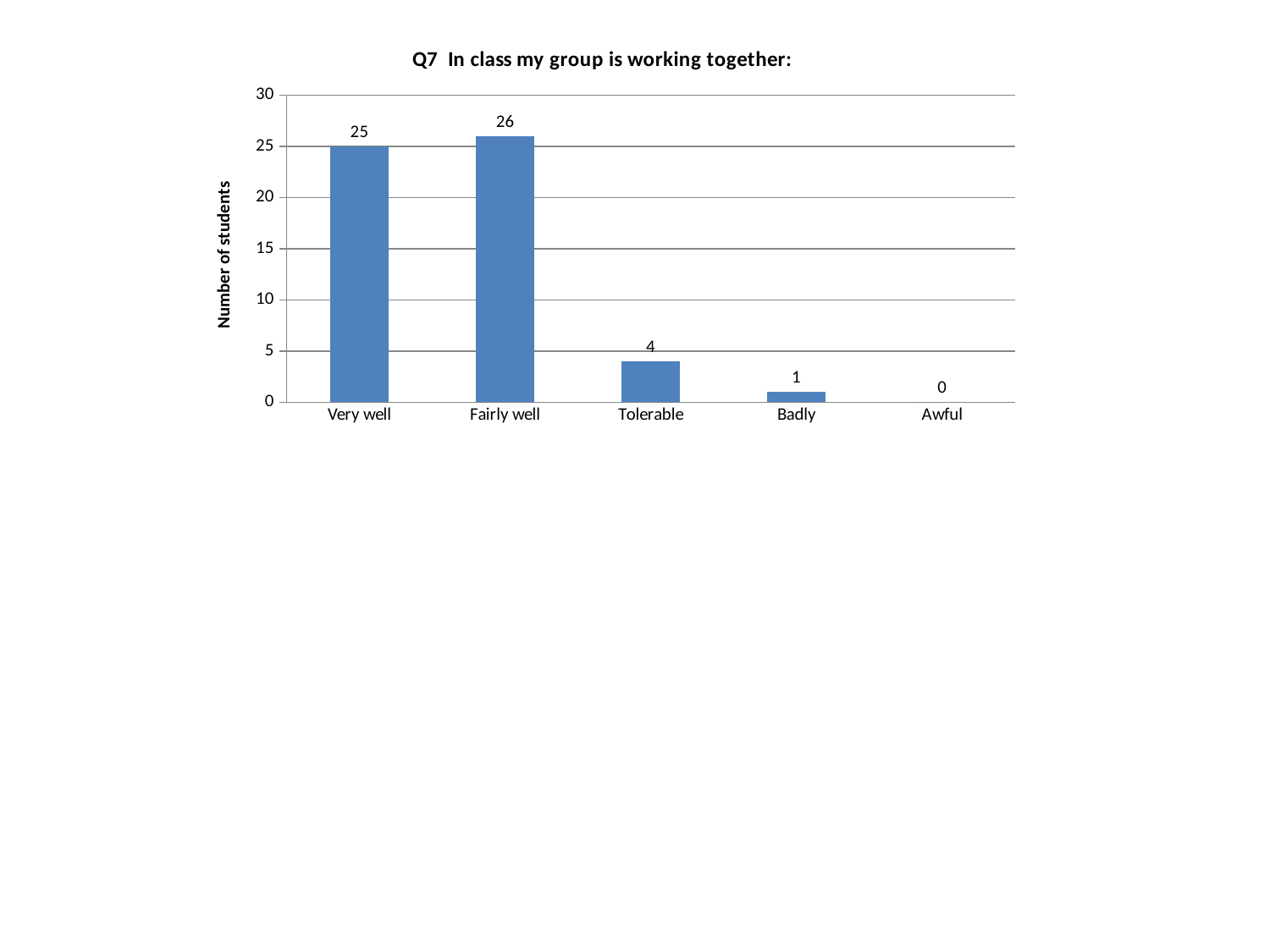
Which category has the lowest number of students? Awful What is the difference between the number of students for Fairly well and Very well? 1 What is the title of the chart? Q7 In class my group is working together: What is the number of students for Very well? 25 What is the number of students for Tolerable? 4 How many categories are shown on the x axis? 5 What is the difference between the number of students for Tolerable and Badly? 3 Is the value for Fairly well greater or less than 20? greater Which has more students, Very well or Tolerable? Very well What kind of chart is shown on the slide? bar chart Which category has the highest number of students? Fairly well What is the number of students for Awful? 0